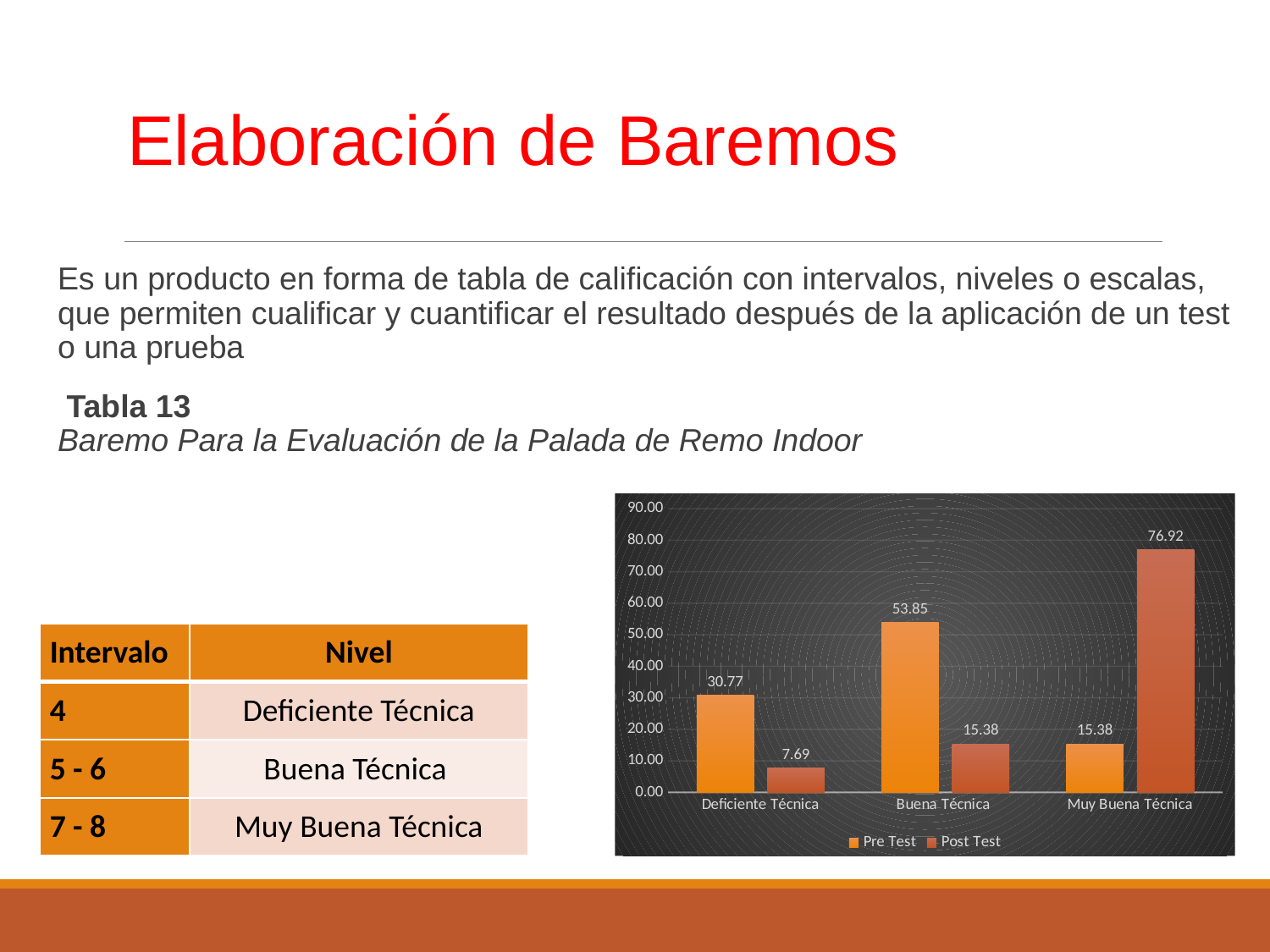
What is the Pre Test value for Buena Técnica? 53.85 Which category has the highest Pre Test value? Buena Técnica Which category has the lowest Post Test value? Deficiente Técnica What is the Post Test value for Deficiente Técnica? 7.69 How many categories are shown on the x axis of the chart? 3 What is the difference between the Post Test and Pre Test values for Muy Buena Técnica? 61.54 How many series does the chart legend list? 2 What kind of chart is shown on the slide? bar chart What is the Post Test value for Muy Buena Técnica? 76.92 What is the Pre Test value for Deficiente Técnica? 30.77 Is the Post Test value for Muy Buena Técnica greater or less than 70.00? greater Which is larger for Buena Técnica, the Pre Test value or the Post Test value? Pre Test